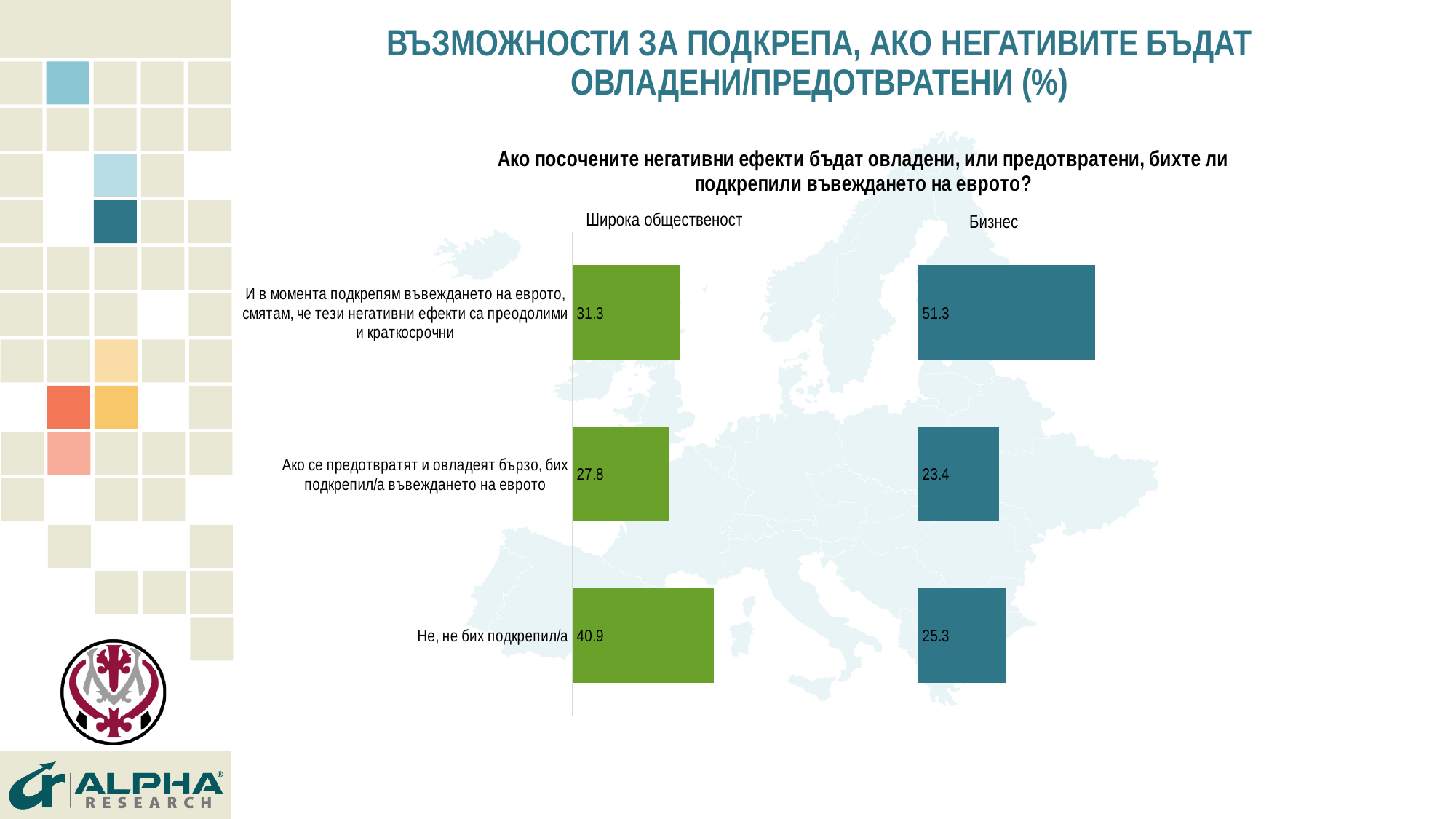
What kind of chart is shown on the slide? Bar chart What is the value for "Бизнес" in the category "И в момента подкрепям въвеждането на еврото, смятам, че тези негативни ефекти са преодолими и краткосрочни"? 51.3 What is the value for "Широка общественост" in the category "Не, не бих подкрепил/а"? 40.9 What colour are the bars for the "Бизнес" series? Teal (dark blue-green) How many categories are shown in the chart? 3 How many series does the chart show? 2 What is the value for "Широка общественост" in the category "Ако се предотвратят и овладеят бързо, бих подкрепил/а въвеждането на еврото"? 27.8 What is the value for "Бизнес" in the category "Ако се предотвратят и овладеят бързо, бих подкрепил/а въвеждането на еврото"? 23.4 In the category "Не, не бих подкрепил/а", which is larger: "Широка общественост" or "Бизнес"? Широка общественост What is the difference between the "Бизнес" and "Широка общественост" values in the category "И в момента подкрепям въвеждането на еврото, смятам, че тези негативни ефекти са преодолими и краткосрочни"? 20.0 Which category has the highest value for "Бизнес"? И в момента подкрепям въвеждането на еврото, смятам, че тези негативни ефекти са преодолими и краткосрочни Which category has the lowest value for "Широка общественост"? Ако се предотвратят и овладеят бързо, бих подкрепил/а въвеждането на еврото